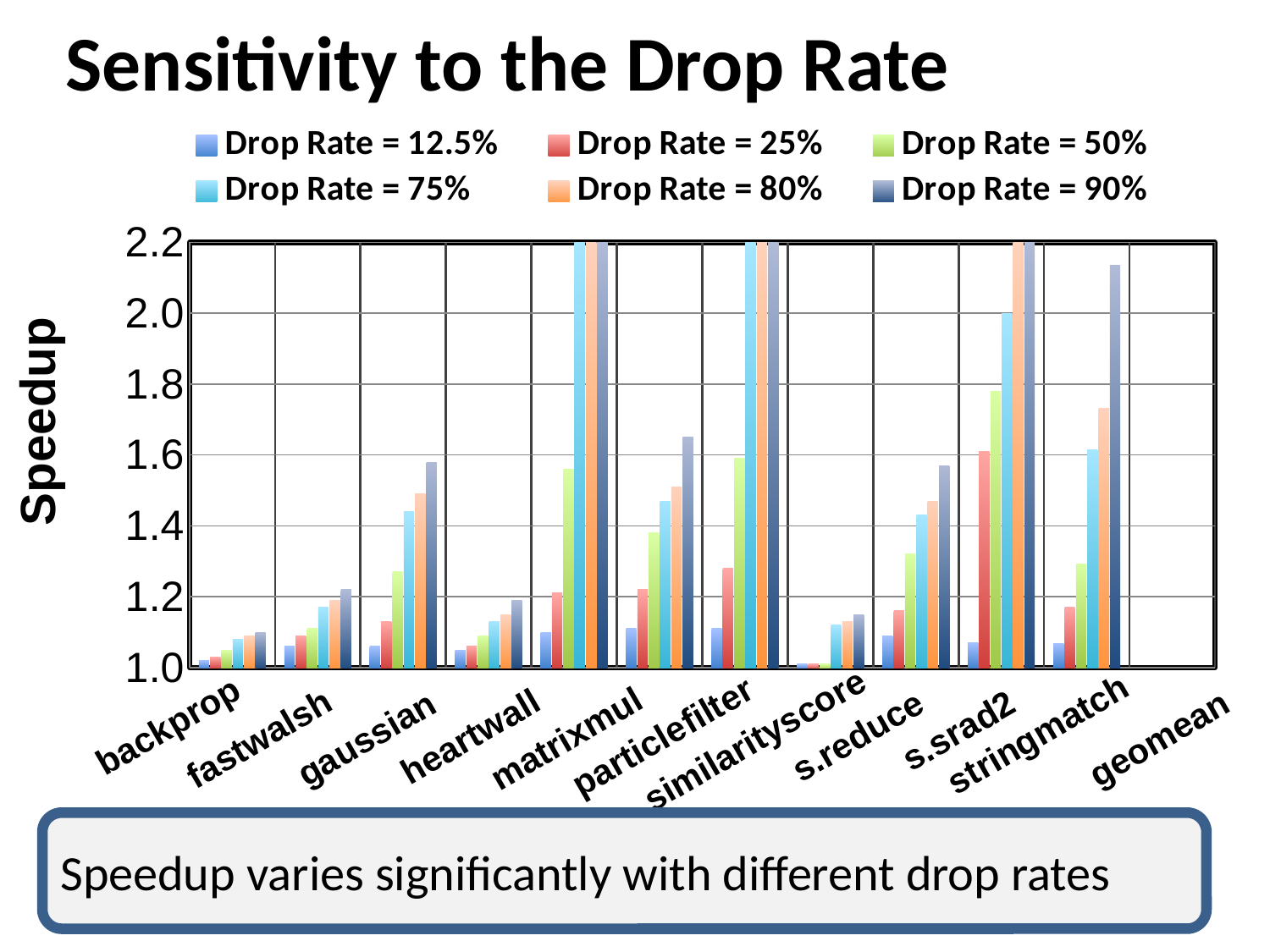
What is the title of the chart? Sensitivity to the Drop Rate Is the value for particlefilter at Drop Rate = 25% greater or less than 1.4? less What is the label on the y axis? Speedup Is the value for backprop at Drop Rate = 90% greater or less than 1.2? less What kind of chart is shown on the slide? bar chart How many series does the legend list? 6 For gaussian, which is larger: the Drop Rate = 75% bar or the Drop Rate = 12.5% bar? Drop Rate = 75% How many categories are labelled along the x axis? 11 Is the value for stringmatch at Drop Rate = 90% greater or less than 2.0? greater